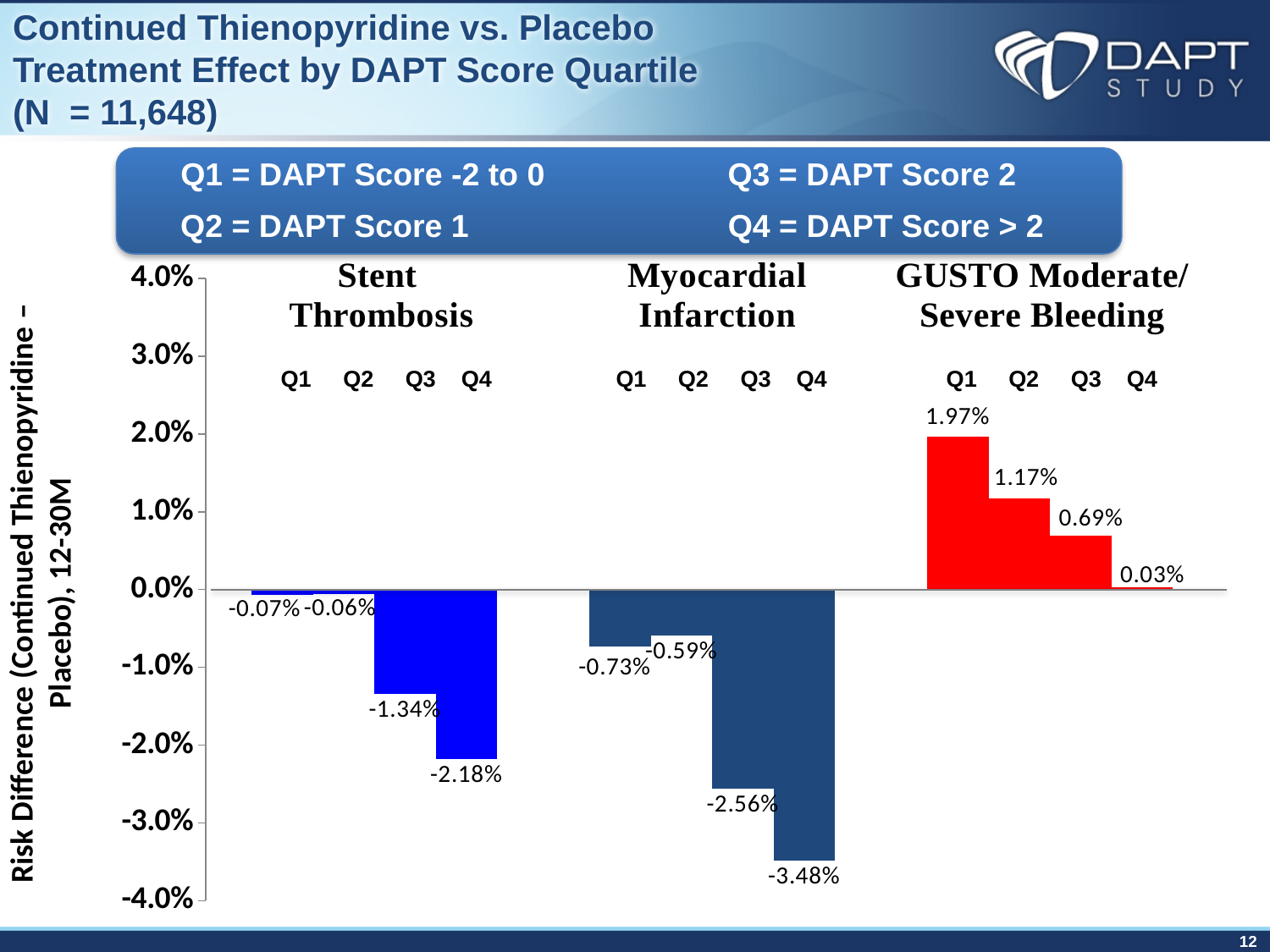
What is the risk difference for Q4 in the Stent Thrombosis group? -2.18% Which quartile has the highest risk difference in the GUSTO Moderate/Severe Bleeding group? Q1 How many bars are plotted in the chart in total? 12 What is the difference between the Q1 and Q4 values in the GUSTO Moderate/Severe Bleeding group? 1.94% What is the risk difference for Q3 in the Myocardial Infarction group? -2.56% Which quartile has the lowest (most negative) risk difference in the Myocardial Infarction group? Q4 Is the Q3 value for Myocardial Infarction greater or less than -2.0%? less Which is larger in magnitude: the Q4 value for Stent Thrombosis or the Q4 value for Myocardial Infarction? Myocardial Infarction Do the values in the GUSTO Moderate/Severe Bleeding group rise or fall from Q1 to Q4? Fall What is the risk difference for Q2 in the Stent Thrombosis group? -0.06% What kind of chart is shown on the slide? Bar chart What is the risk difference for Q1 in the GUSTO Moderate/Severe Bleeding group? 1.97%